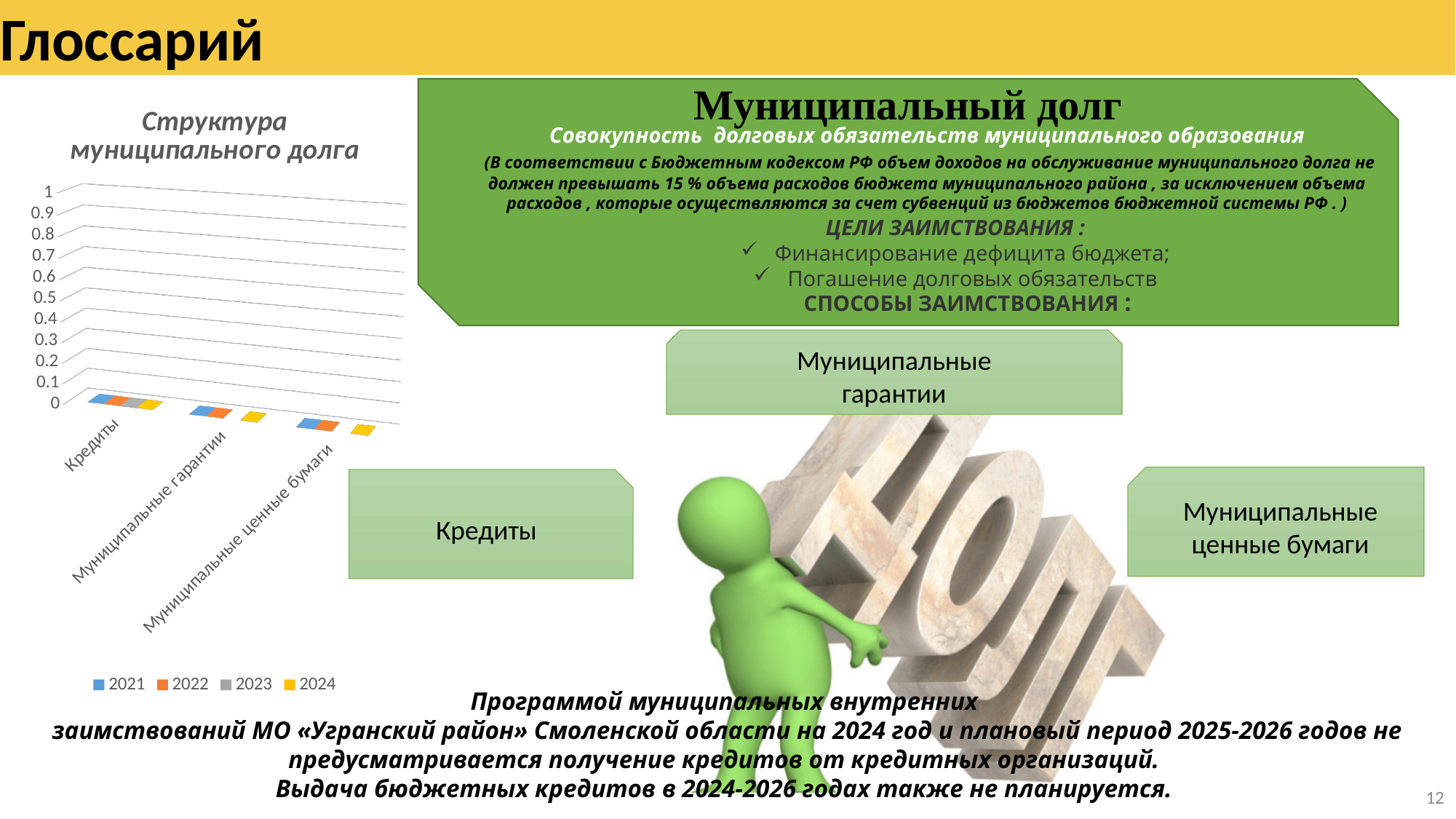
How many series does the chart legend list? 4 Is the value for Кредиты in 2021 greater or less than 0.1? less How many categories are shown on the x axis of the chart? 3 What is the title of the chart on the slide? Структура муниципального долга What kind of chart is shown on the slide? bar chart Is the value for Муниципальные ценные бумаги in 2022 greater or less than 0.1? less Is the value for Муниципальные гарантии in 2024 greater or less than 0.5? less Which years are listed in the chart legend? 2021, 2022, 2023, 2024 What is the highest tick value shown on the vertical axis of the chart? 1